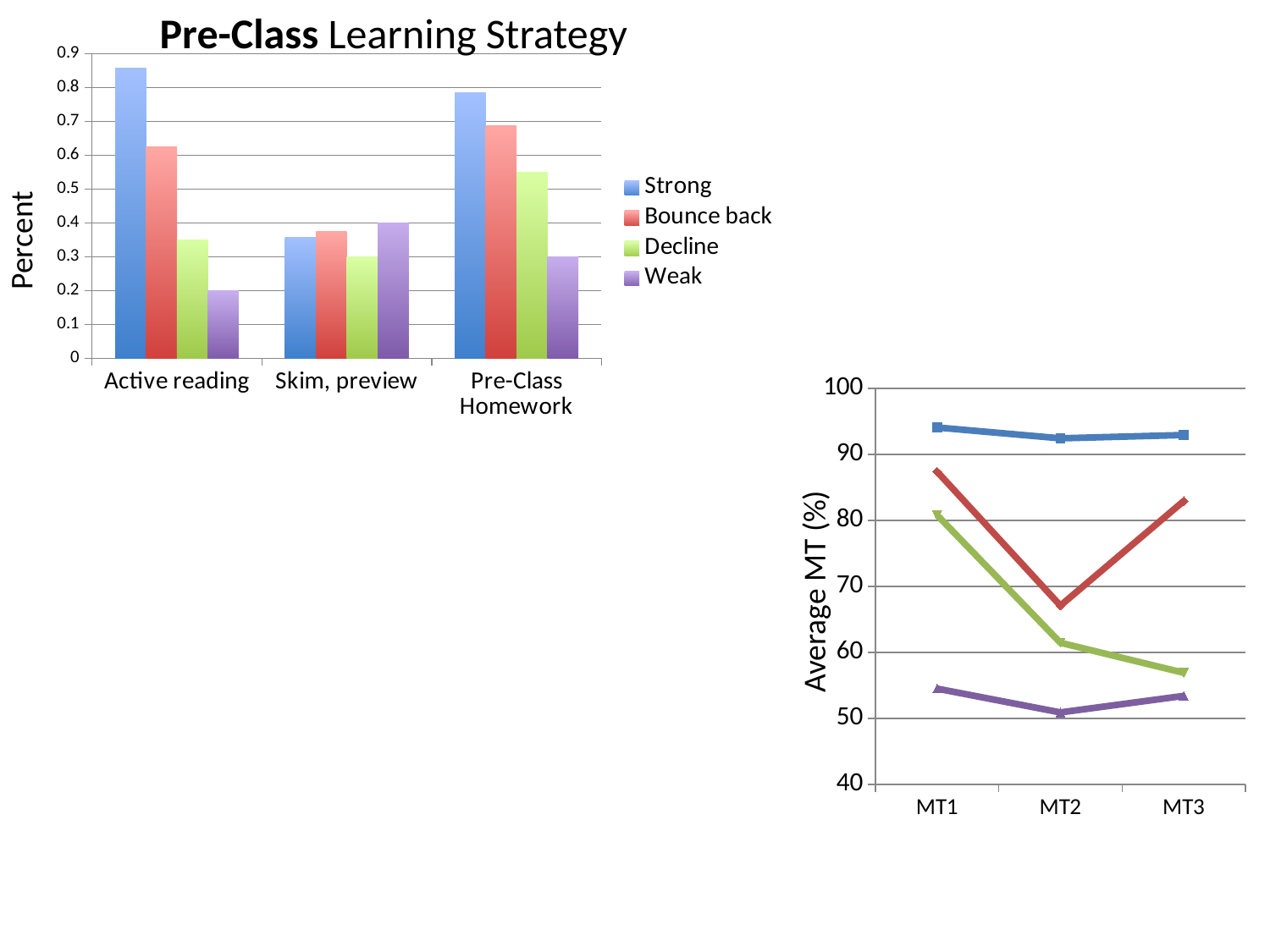
What kind of chart is the chart at the bottom right of the slide with the 'Average MT (%)' axis? line chart How many categories are shown on the x axis of the 'Pre-Class Learning Strategy' chart? 3 In the bottom-right line chart, does the green line rise or fall from MT1 to MT3? fall In the bottom-right line chart, is the value of the red line at MT2 greater or less than 70? less What kind of chart is the 'Pre-Class Learning Strategy' chart? bar chart In the bottom-right line chart, how many points are shown on the x axis? 3 In the 'Pre-Class Learning Strategy' chart, which series has the lowest value for Pre-Class Homework? Weak In the 'Pre-Class Learning Strategy' chart, which series has the highest value for Active reading? Strong How many series does the legend of the 'Pre-Class Learning Strategy' chart list? 4 In the 'Pre-Class Learning Strategy' chart, is the value for Strong in Active reading greater or less than 0.8? greater In the 'Pre-Class Learning Strategy' chart, which is larger for Skim, preview: Weak or Decline? Weak In the 'Pre-Class Learning Strategy' chart, is the value for Decline in Pre-Class Homework greater or less than 0.5? greater